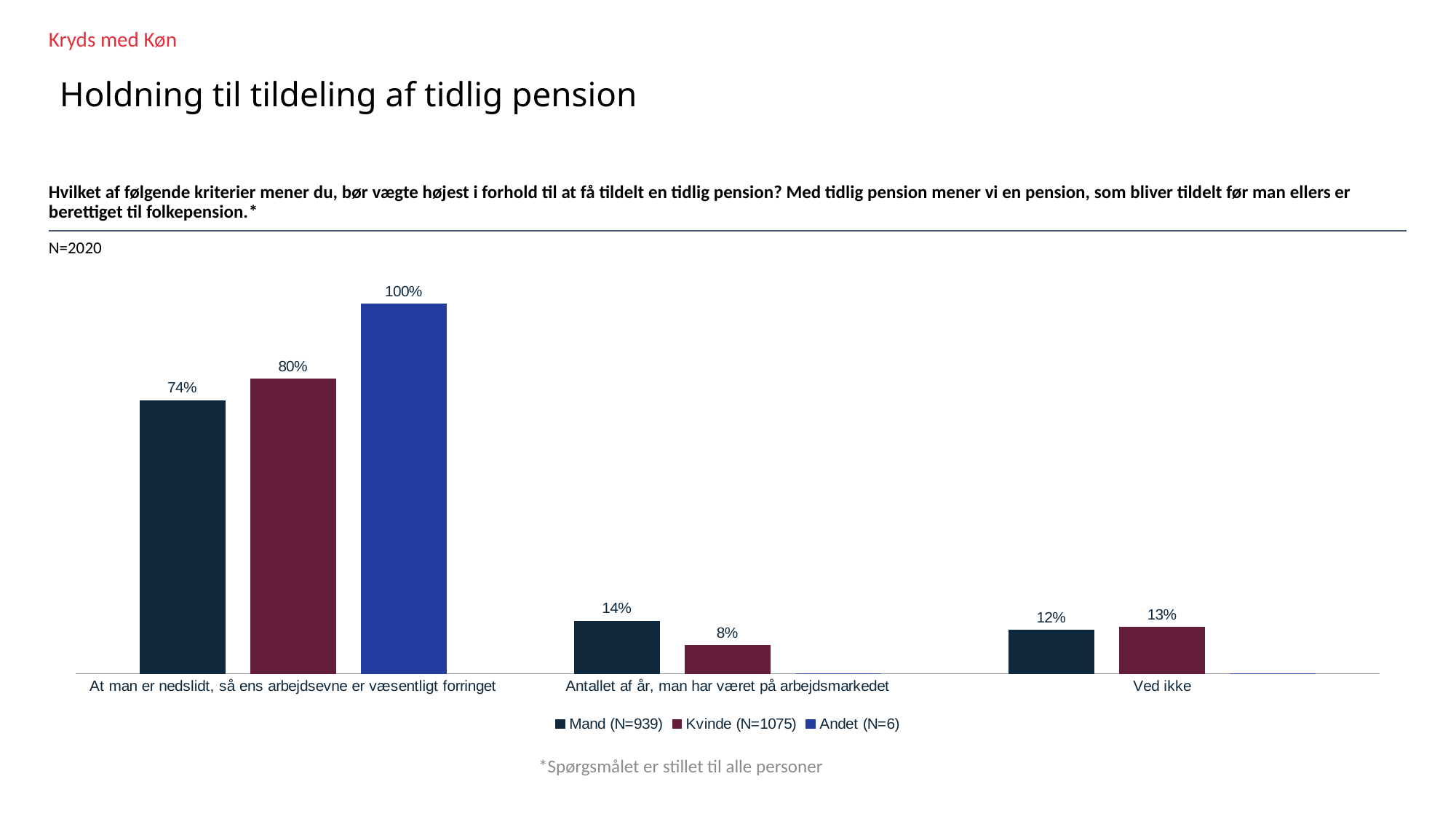
What percentage of Mand (N=939) respondents chose 'At man er nedslidt, så ens arbejdsevne er væsentligt forringet'? 74% What is the value for Andet (N=6) in the category 'At man er nedslidt, så ens arbejdsevne er væsentligt forringet'? 100% Which is larger for 'Antallet af år, man har været på arbejdsmarkedet': the Mand (N=939) value or the Kvinde (N=1075) value? Mand (N=939) Which category has the lowest value for Mand (N=939)? Ved ikke Which series has the highest value in the category 'At man er nedslidt, så ens arbejdsevne er væsentligt forringet'? Andet (N=6) What percentage of Kvinde (N=1075) respondents chose 'Antallet af år, man har været på arbejdsmarkedet'? 8% How many series does the legend list? 3 What is the sample size (N) stated above the chart? N=2020 What percentage of Kvinde (N=1075) respondents answered 'Ved ikke'? 13% What kind of chart is shown on the slide? Bar chart How many categories are shown on the x axis of the chart? 3 What is the difference between the Kvinde (N=1075) and Mand (N=939) values for 'At man er nedslidt, så ens arbejdsevne er væsentligt forringet'? 6%